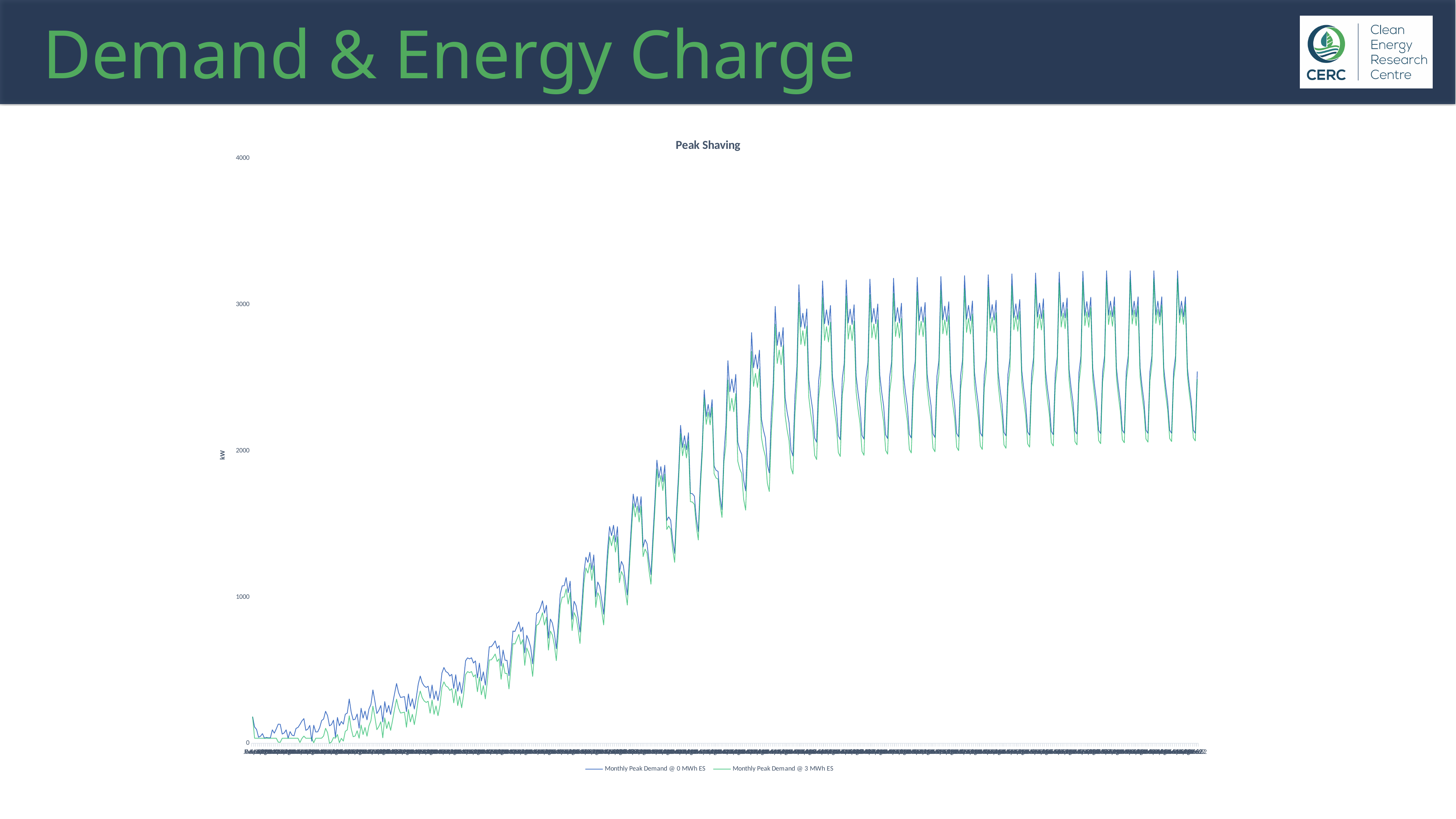
What is the title of the chart? Peak Shaving What kind of chart is shown on the slide? Line chart What unit is shown on the vertical axis of the chart? kW Is the highest value of the Monthly Peak Demand @ 0 MWh ES series greater or less than 3000? greater Is the highest value of the Monthly Peak Demand @ 3 MWh ES series greater or less than 2000? greater Which series reaches higher peak values, Monthly Peak Demand @ 0 MWh ES or Monthly Peak Demand @ 3 MWh ES? Monthly Peak Demand @ 0 MWh ES How many series does the chart's legend list? 2 What is the highest value shown on the vertical axis of the chart? 4000 Is the highest value of the Monthly Peak Demand @ 0 MWh ES series greater or less than 4000? less Do the values in the chart generally rise or fall from left to right along the x axis? Rise